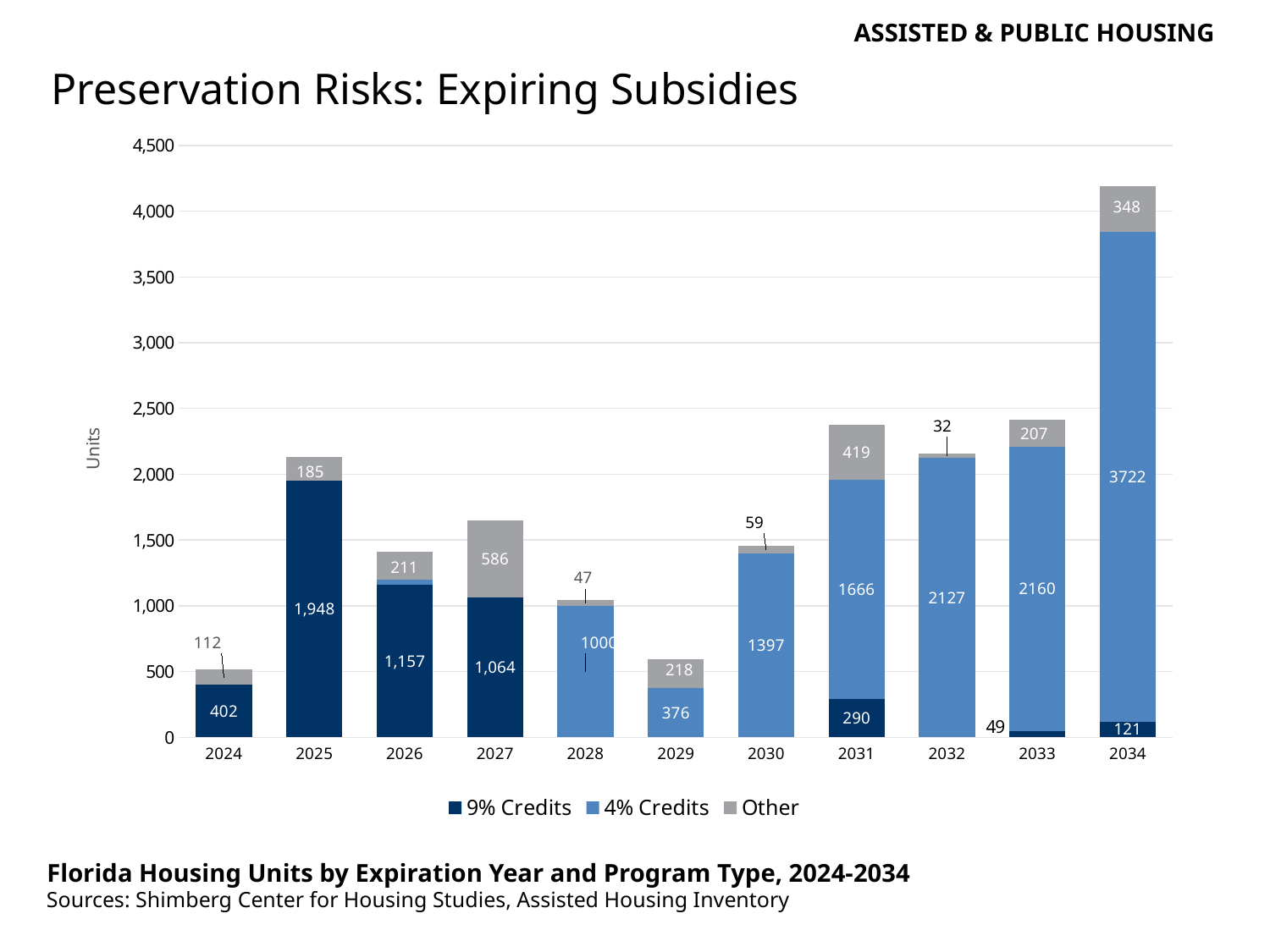
What is the value for 4% Credits in 2034? 3722 How many expiration years are shown on the x axis? 11 Which year has the tallest total bar? 2034 What is the value for Other in 2027? 586 Which year has the largest Other value? 2027 What is the total of the stacked bar for 2031? 2,375 Which year has the larger 9% Credits value, 2026 or 2027? 2026 How many series does the legend list? 3 What is the difference between the 4% Credits values for 2033 and 2032? 33 What is the value for 9% Credits in 2025? 1,948 What kind of chart is shown on the slide? Stacked bar chart What is the value for Other in 2032? 32